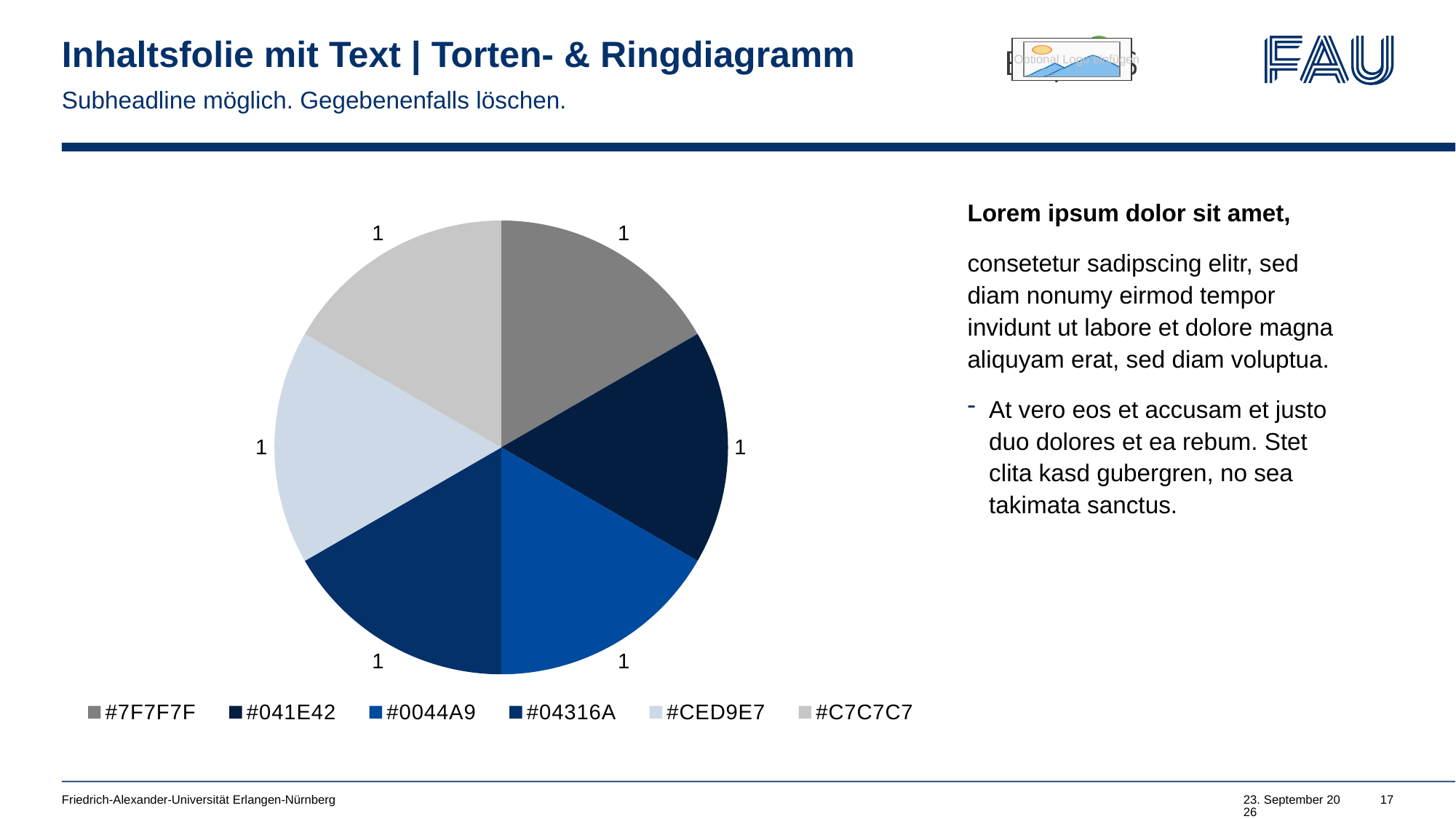
What is the value of the #7F7F7F slice in the pie chart? 1 What is the difference between the values of the #041E42 and #C7C7C7 slices? 0 How many entries does the legend of the pie chart list? 6 What is the total of all slice values in the pie chart? 6 What is the value of the #0044A9 slice in the pie chart? 1 How many slices does the pie chart have? 6 What is the value of the #CED9E7 slice in the pie chart? 1 What share of the pie does the #04316A slice represent? 1/6 Which legend entry is listed last in the pie chart's legend? #C7C7C7 Which legend entry is listed first in the pie chart's legend? #7F7F7F What kind of chart is shown on the slide? pie chart